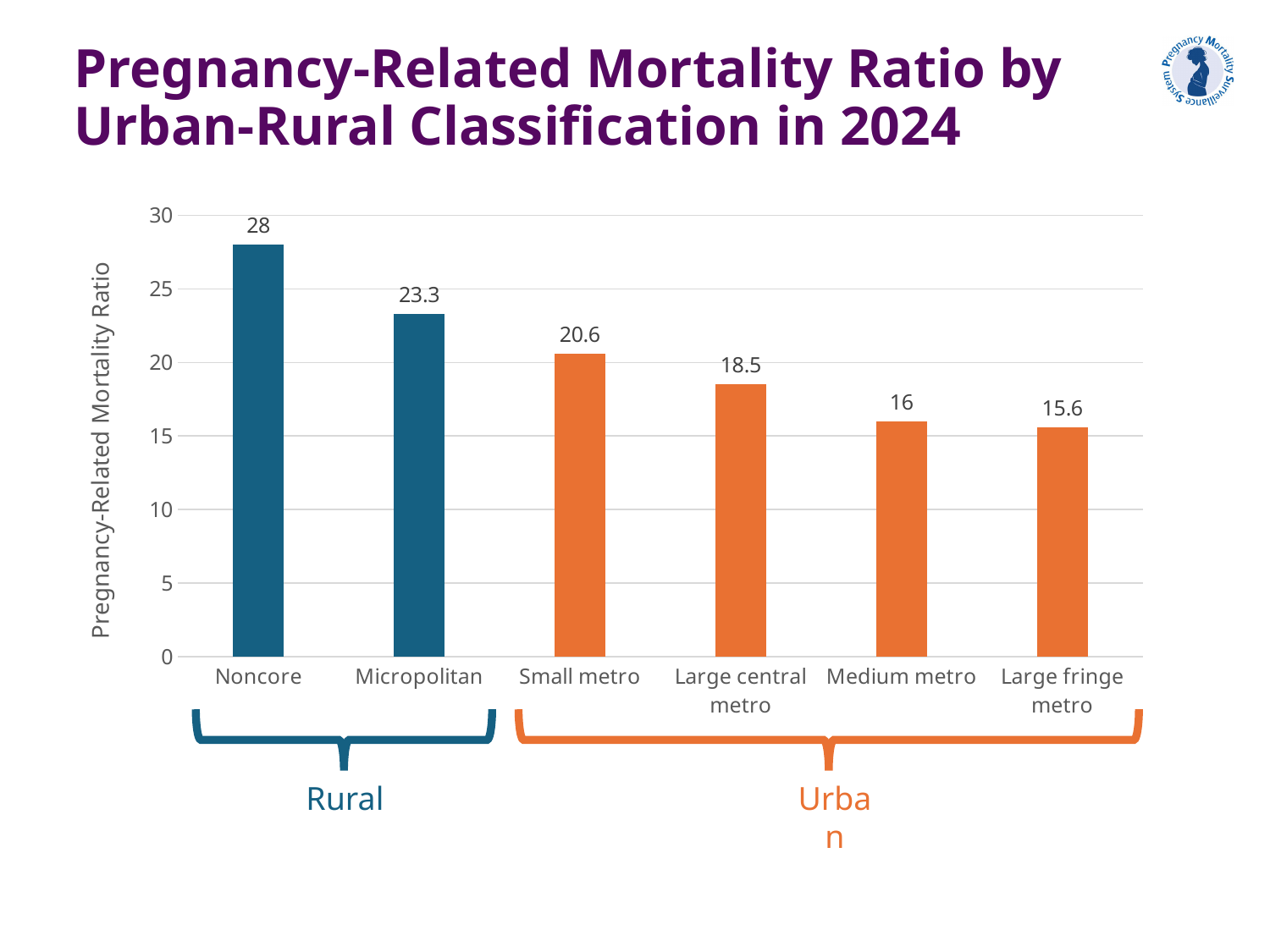
Which urban-rural classification has the lowest pregnancy-related mortality ratio? Large fringe metro Do the pregnancy-related mortality ratios rise or fall from left to right across the categories? Fall What is the pregnancy-related mortality ratio for Large fringe metro? 15.6 Which has a higher pregnancy-related mortality ratio, Small metro or Large central metro? Small metro What is the difference between the pregnancy-related mortality ratio for Noncore and for Micropolitan? 4.7 What is the difference between the pregnancy-related mortality ratio for Small metro and for Medium metro? 4.6 Which urban-rural classification has the highest pregnancy-related mortality ratio? Noncore What is the pregnancy-related mortality ratio for Micropolitan? 23.3 What kind of chart is shown on the slide? Bar chart How many urban-rural classifications are shown on the chart? 6 What is the pregnancy-related mortality ratio for Noncore? 28 What is the pregnancy-related mortality ratio for Large central metro? 18.5